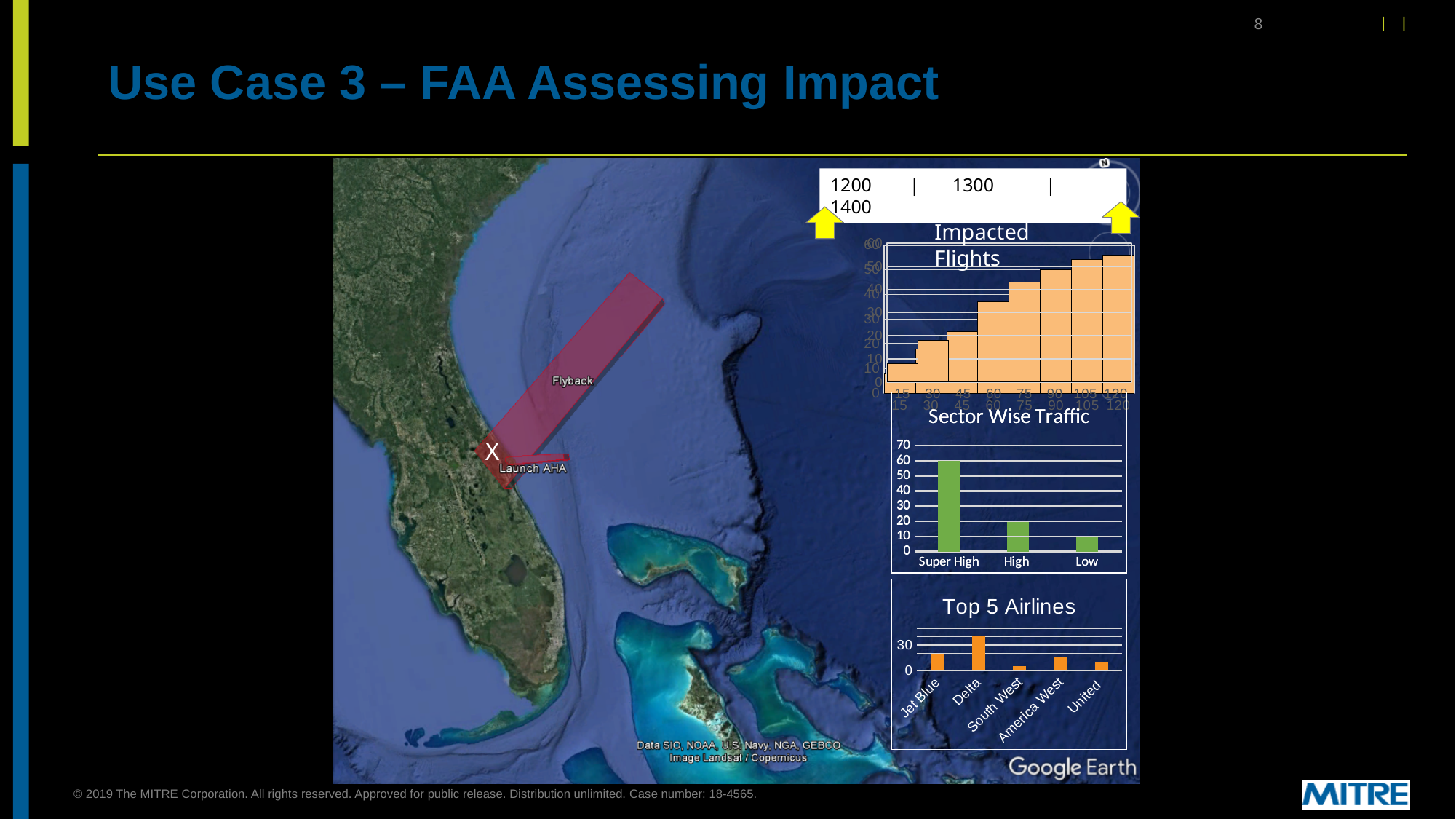
In the Top 5 Airlines chart, is the value for Jet Blue greater or less than 30? less In the Top 5 Airlines chart, which airline has the highest value? Delta In the Sector Wise Traffic chart, is the value for High greater or less than 30? less In the Sector Wise Traffic chart, which category has the lowest value? Low In the Top 5 Airlines chart, which airline has the lowest value? South West In the Sector Wise Traffic chart, what is the value for Super High? 60 In the Top 5 Airlines chart, which is larger, the value for Jet Blue or the value for United? Jet Blue In the Impacted Flights chart, do the values rise or fall from left to right along the x axis? rise In the Sector Wise Traffic chart, how many categories are shown on the x axis? 3 What kind of chart is the Sector Wise Traffic chart? bar chart In the Top 5 Airlines chart, how many airlines are shown? 5 In the Sector Wise Traffic chart, which category has the highest value? Super High